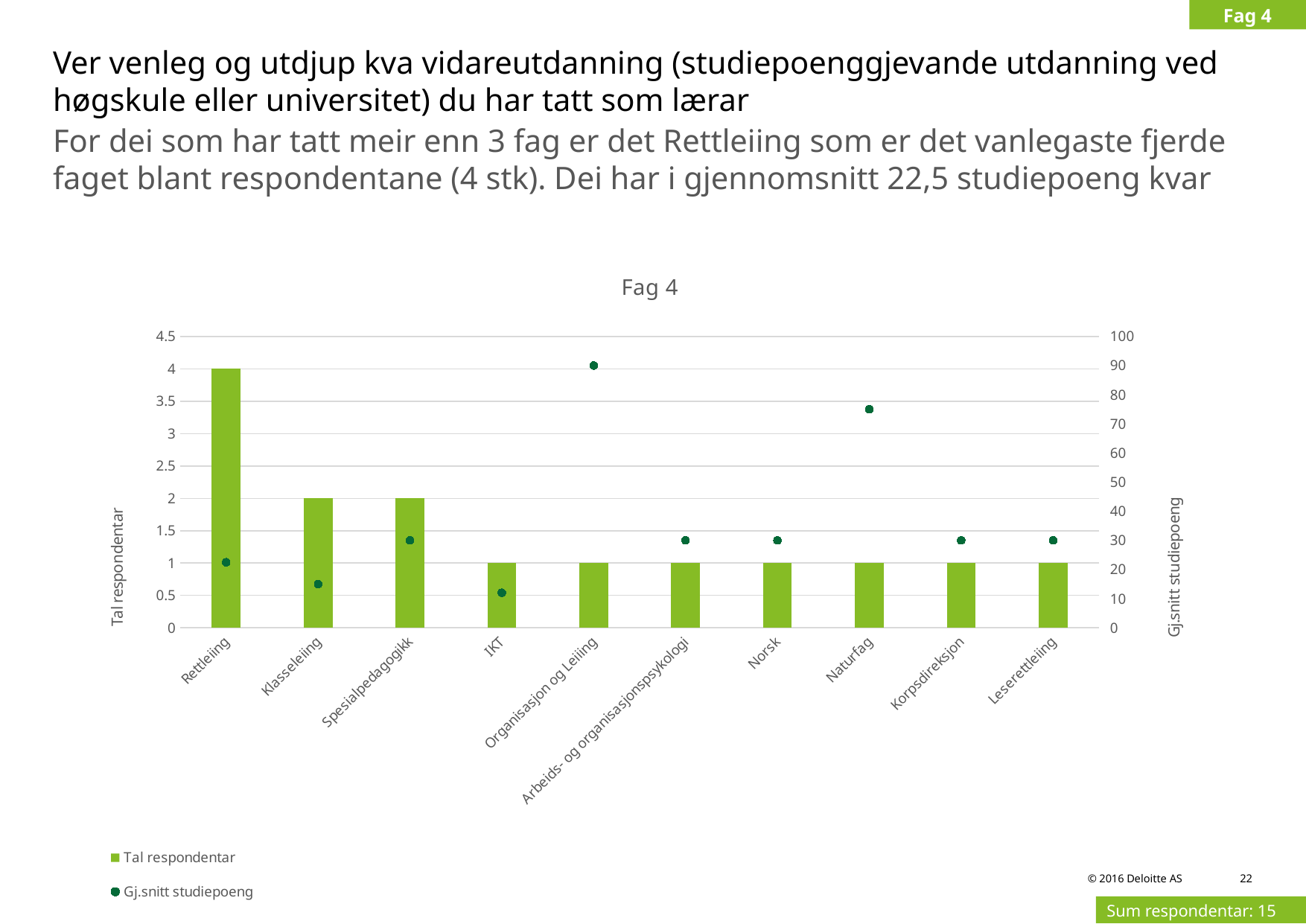
Is the Gj.snitt studiepoeng value for Naturfag greater or less than 70? greater Is the Gj.snitt studiepoeng value for Klasseleiing greater or less than 20? less What is the Tal respondentar value for Rettleiing? 4 What is the Gj.snitt studiepoeng value for Organisasjon og Leiing? 90 What is the Tal respondentar value for Klasseleiing? 2 What kind of chart is used to show Tal respondentar? bar chart Which category has the highest Gj.snitt studiepoeng? Organisasjon og Leiing What is the difference in Tal respondentar between Rettleiing and Klasseleiing? 2 How many categories are shown on the x axis? 10 Which category has the highest Tal respondentar? Rettleiing What is the title of the chart? Fag 4 How many series does the legend list? 2